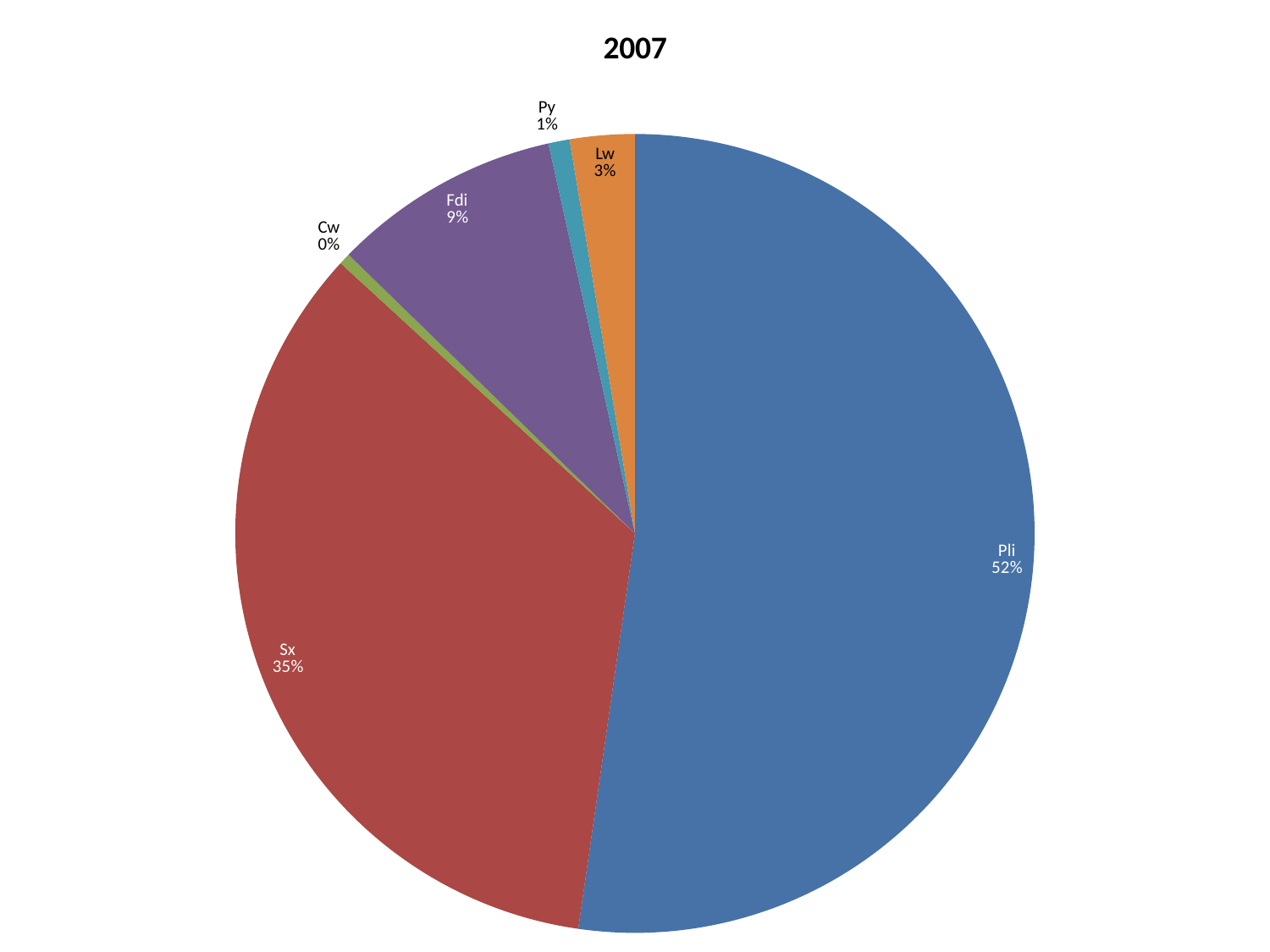
What is the title of the chart? 2007 Which category has the largest slice of the pie? Pli What kind of chart is shown on the slide? pie chart What percentage is shown for Lw? 3% What percentage is shown for Cw? 0% What is the difference in percentage points between Pli and Sx? 17 Which category has the smallest slice of the pie? Cw How many slices does the pie chart have? 6 What share of the pie does Pli have? 52% What percentage is shown for Fdi? 9% Which is larger, the share for Fdi or the share for Lw? Fdi What share of the pie does Sx have? 35%